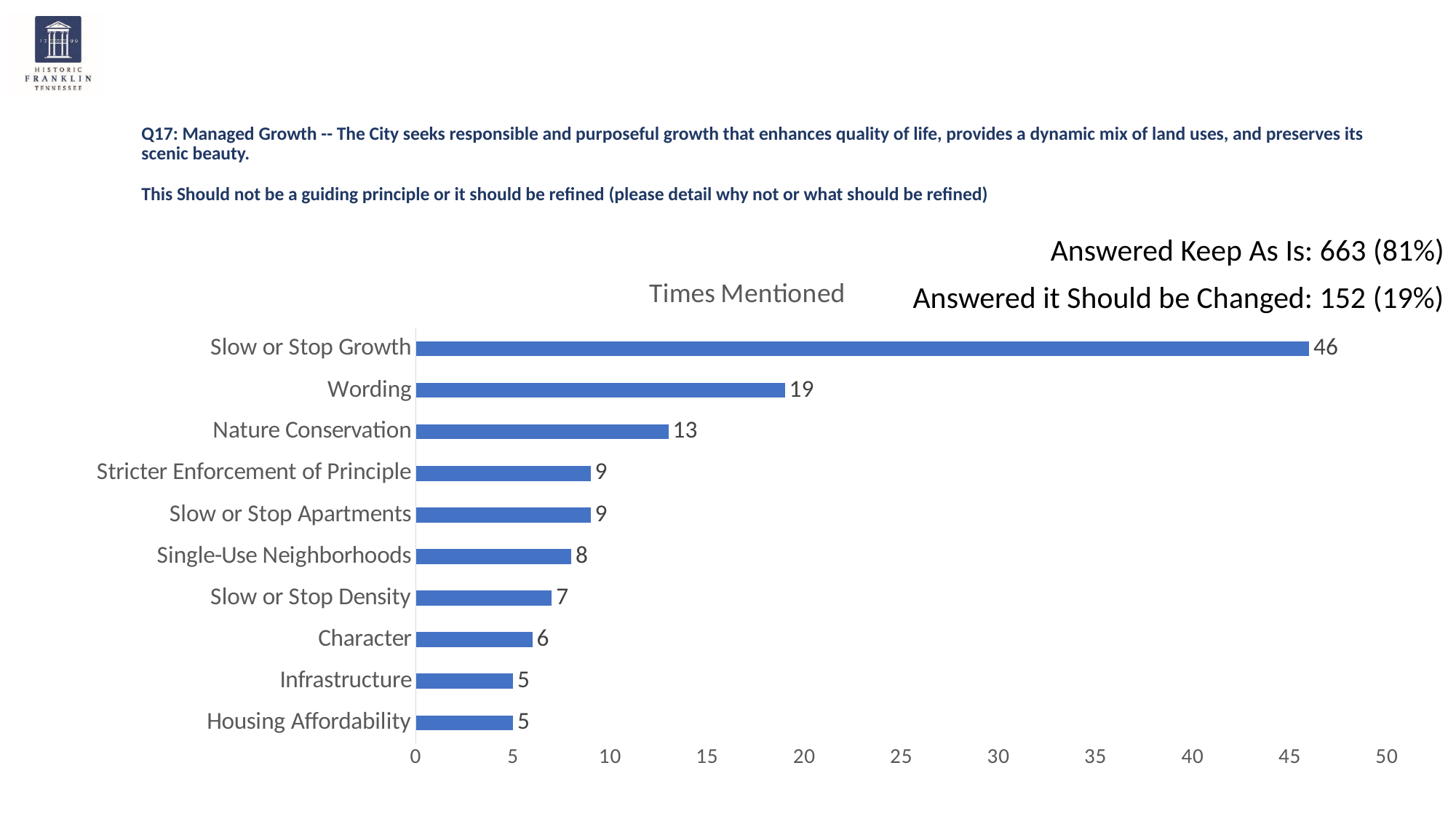
Is the value for Slow or Stop Growth greater or less than 40? greater What is the maximum value shown on the x axis? 50 What is the value for Character? 6 Which is larger, the value for Wording or the value for Slow or Stop Density? Wording What is the value for Nature Conservation? 13 Which category has the highest number of times mentioned? Slow or Stop Growth What kind of chart is shown on the slide? bar chart What is the difference between the values for Nature Conservation and Single-Use Neighborhoods? 5 What is the title of the chart? Times Mentioned How many categories are shown in the chart? 10 What is the difference between the values for Slow or Stop Growth and Wording? 27 How many times was Slow or Stop Growth mentioned? 46